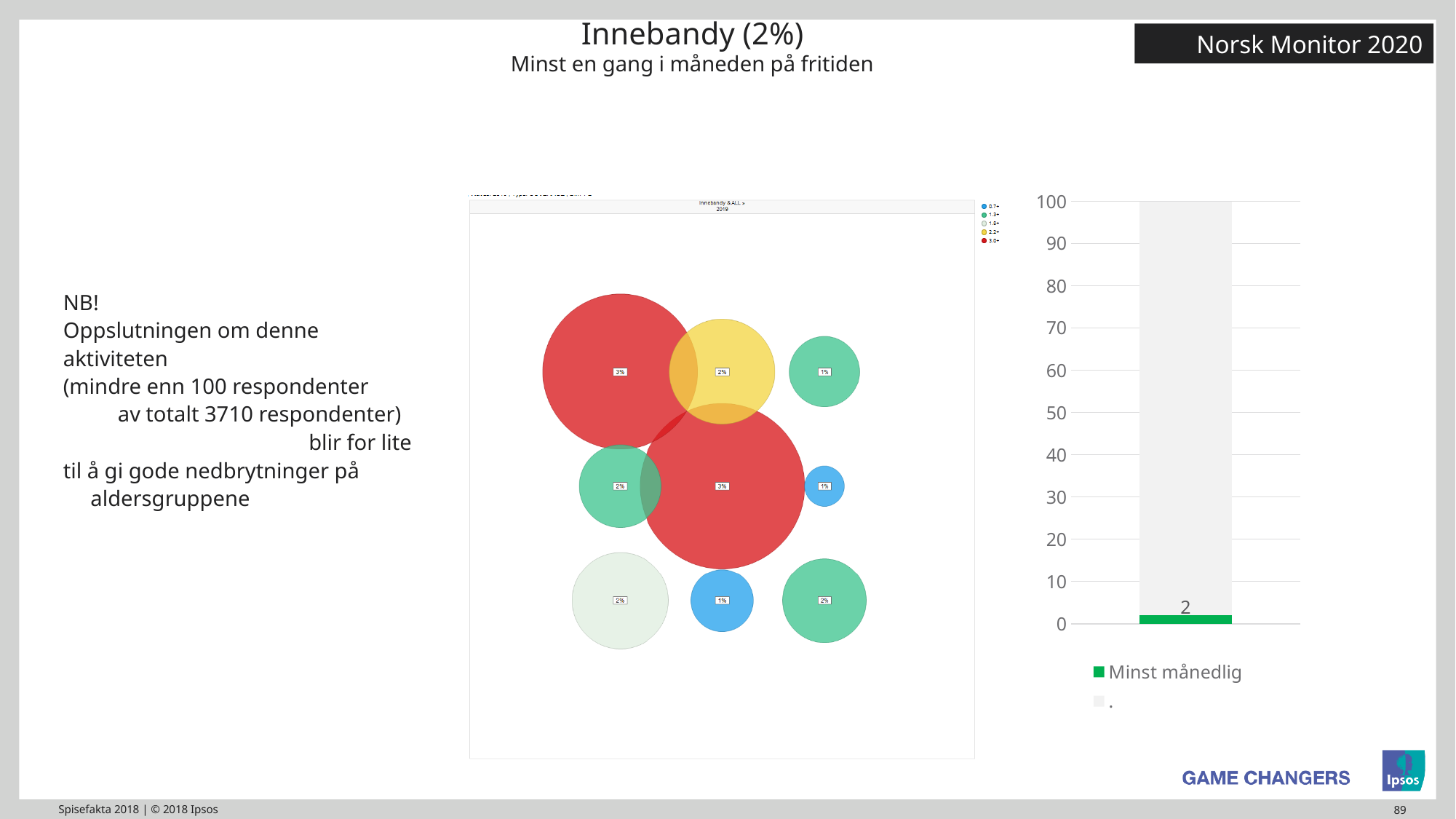
In the bar chart on the right, what is the highest value shown on the vertical axis? 100 In the bar chart on the right, what colour is the bar for 'Minst månedlig'? green In the bubble chart in the middle of the slide, what is the lowest value labelled on any bubble? 1% What kind of chart is shown on the right side of the slide? bar chart In the bar chart on the right, is the value for 'Minst månedlig' greater or less than 10? less What kind of chart is shown in the middle of the slide? bubble chart In the bubble chart in the middle of the slide, how many bubbles are plotted? 9 In the bubble chart in the middle of the slide, how many bubbles are labelled 3%? 2 In the bubble chart in the middle of the slide, what is the highest value labelled on any bubble? 3% In the bar chart on the right, what is the value of the bar for 'Minst månedlig'? 2 What percentage is given in the slide title for Innebandy? 2%